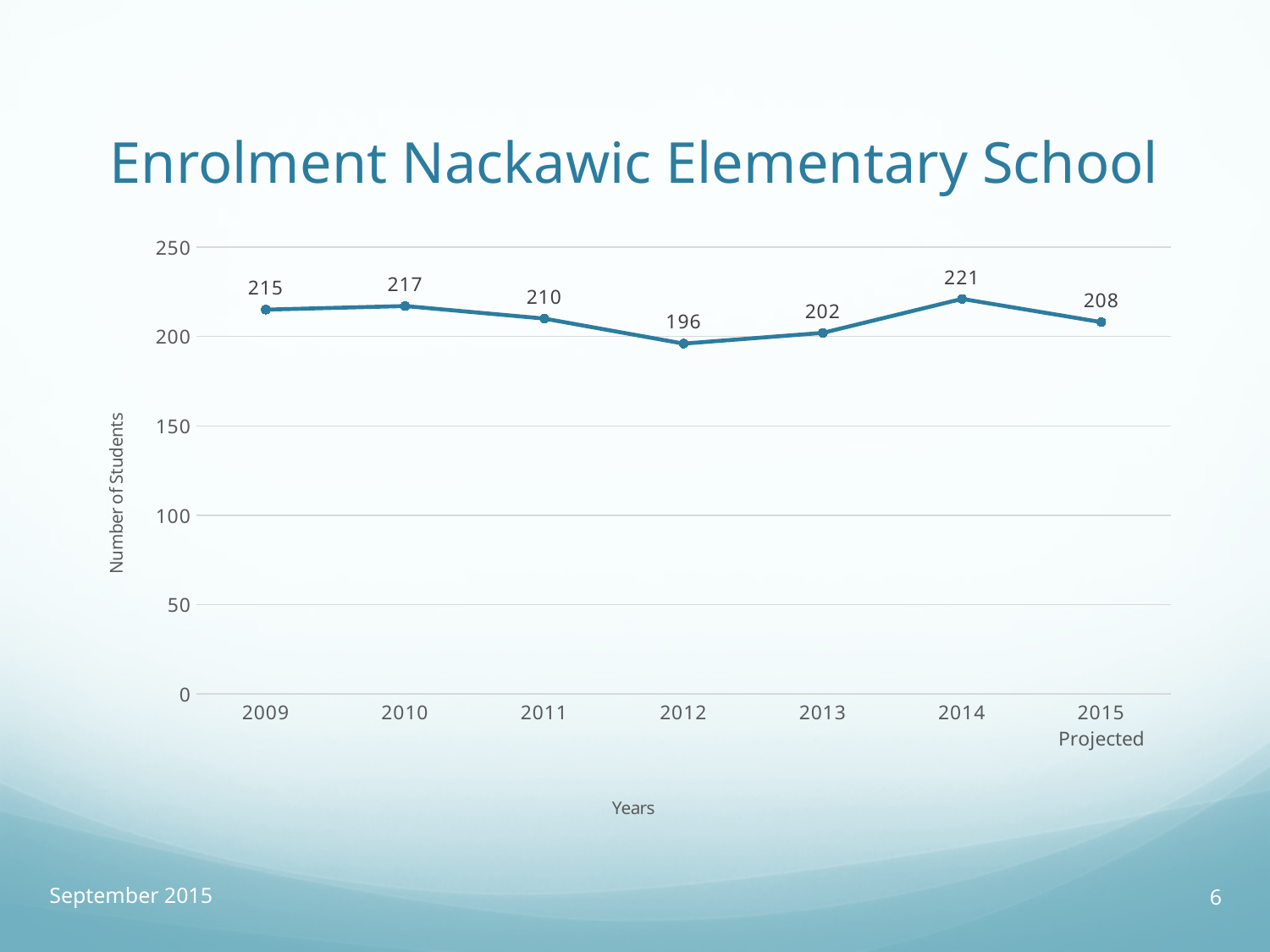
Is the enrolment for 2012 greater or less than 200? less What was the enrolment in 2010? 217 What type of chart is shown on the slide? line chart What is the difference in enrolment between 2014 and 2012? 25 What is the difference in enrolment between 2009 and 2013? 13 What is the projected enrolment for 2015? 208 How many years are plotted on the chart? 7 Which year had higher enrolment, 2011 or 2013? 2011 Which year has the lowest enrolment? 2012 Which year has the highest enrolment? 2014 What was the enrolment at Nackawic Elementary School in 2012? 196 Did enrolment rise or fall from 2014 to 2015 Projected? fall